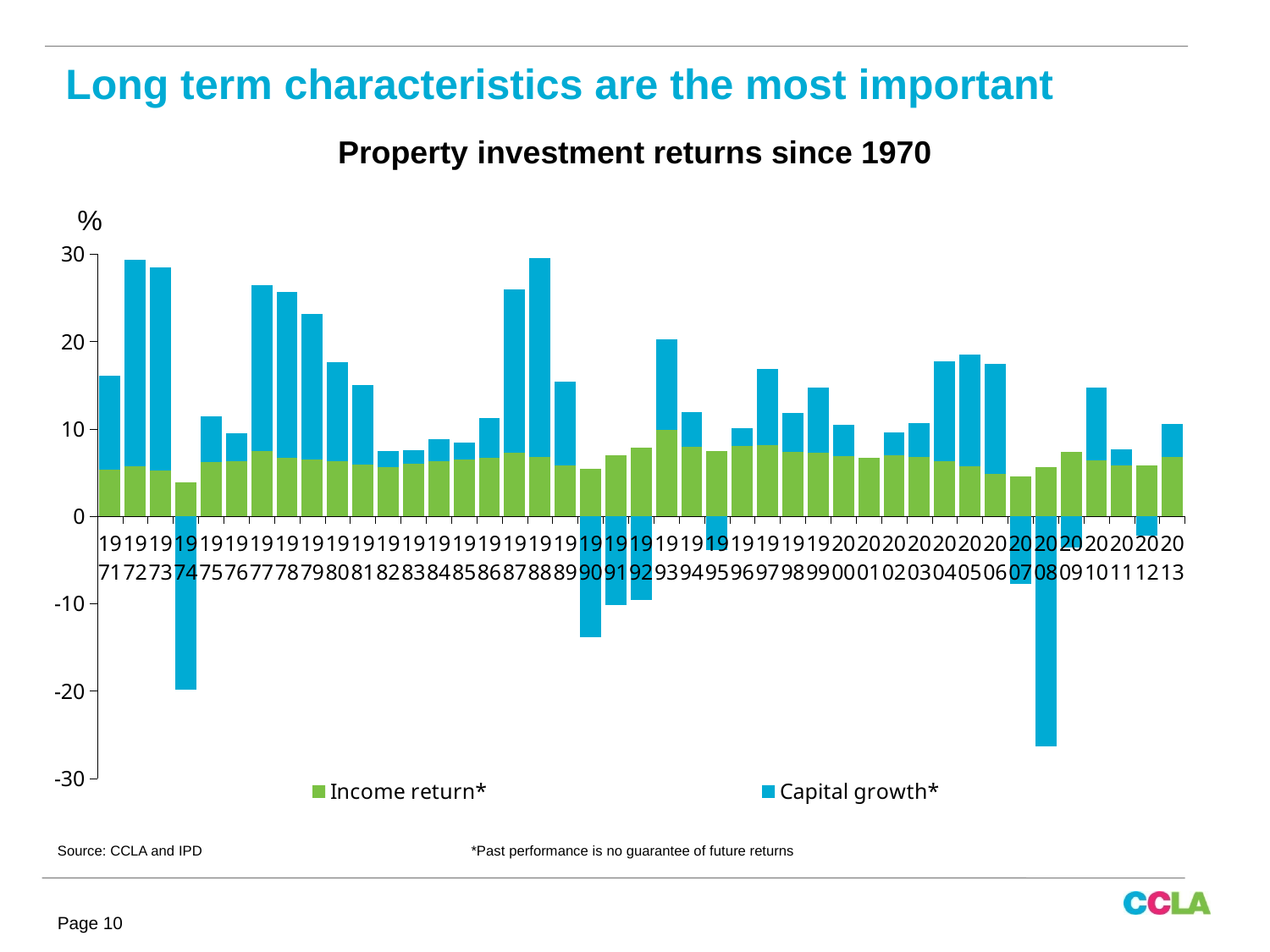
How many years are plotted along the x axis? 43 Which year has the lowest capital growth? 2008 What are the two series named in the legend? Income return* and Capital growth* Which year has the lower capital growth, 1974 or 1990? 1974 What is the title of the chart? Property investment returns since 1970 Is the capital growth for 2008 greater or less than -20? less Is the capital growth for 1974 greater or less than -10? less How many series does the legend list? 2 What kind of chart is shown on the slide? Stacked bar chart Which year has the lower capital growth, 2008 or 1974? 2008 Is the capital growth for 1988 greater or less than 20? greater